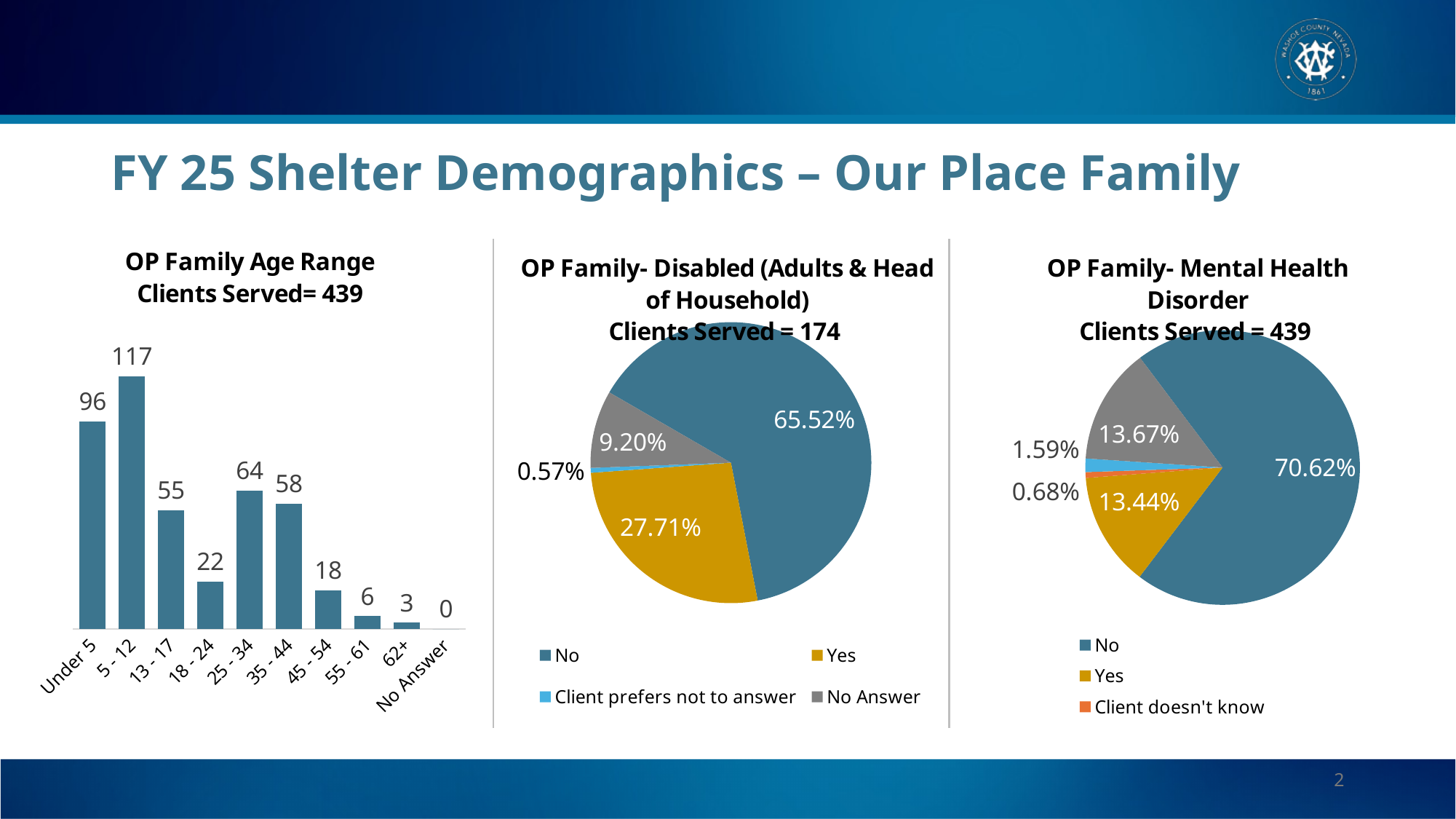
How many categories are shown in the OP Family Age Range chart? 10 In the OP Family Age Range chart, which category has the lowest value? No Answer What kind of chart is the OP Family Age Range chart? bar chart In the OP Family Age Range chart, what is the difference between the Under 5 and 13 - 17 values? 41 In the OP Family- Disabled pie chart, what share is labelled Yes? 27.71% In the OP Family- Mental Health Disorder pie chart, what share is labelled No? 70.62% In the OP Family- Disabled pie chart, which slice is the largest? No In the OP Family Age Range chart, which is larger: 25 - 34 or 35 - 44? 25 - 34 According to its title, how many clients were served in the OP Family- Mental Health Disorder chart? 439 How many entries does the legend of the OP Family- Disabled pie chart list? 4 In the OP Family Age Range chart, which age range has the highest number of clients? 5 - 12 In the OP Family Age Range chart, how many clients were in the 5 - 12 age range? 117